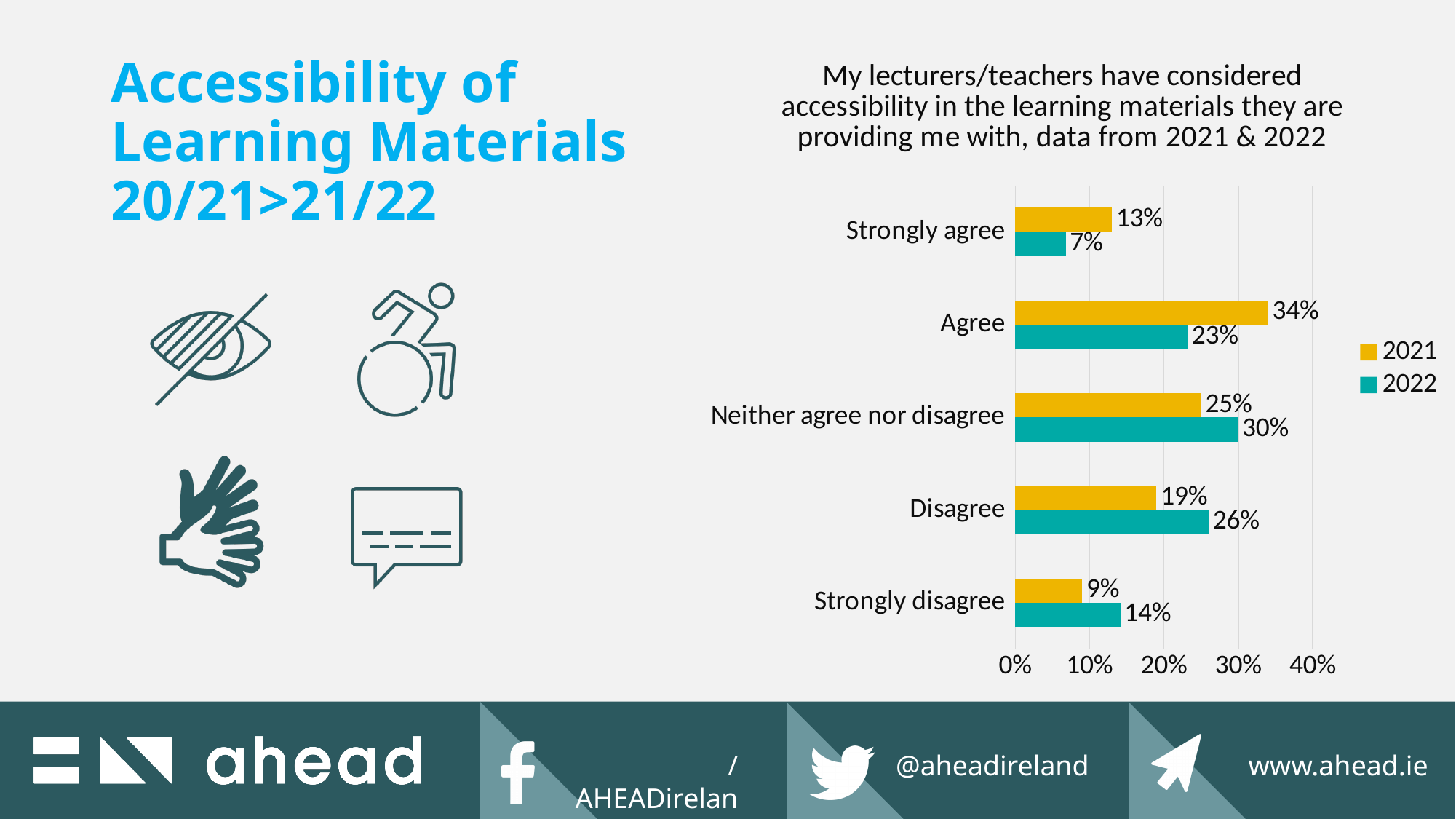
What is the difference between the 2021 and 2022 values for Agree? 11% What is the 2021 value for Agree? 34% Which category has the lowest 2022 value? Strongly agree How many categories are shown on the chart? 5 Which category has the highest 2021 value? Agree Which is larger for Disagree, the 2021 value or the 2022 value? 2022 What kind of chart is shown on the slide? Bar chart What is the 2022 value for Strongly agree? 7% Which colour represents 2022 in the chart? Teal What is the 2022 value for Neither agree nor disagree? 30% What is the 2021 value for Strongly disagree? 9% How many series does the legend list? 2